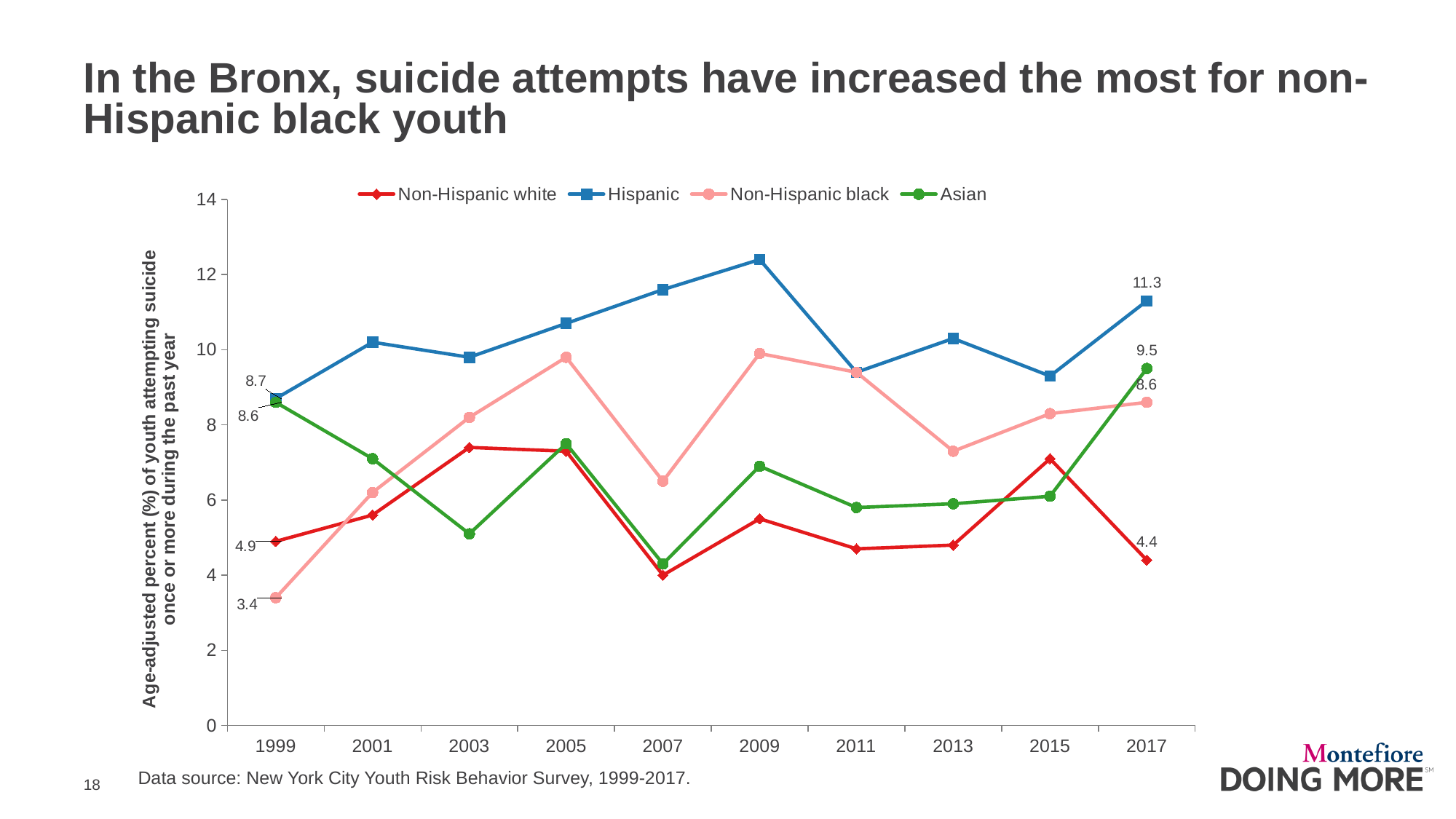
What kind of chart is shown on the slide? line chart By how much did the value for Non-Hispanic black youth change from 1999 to 2017? 5.2 Is the value for Hispanic youth in 2009 greater or less than 12? greater What is the value for Hispanic youth in 2017? 11.3 How many years are shown on the x axis? 10 What is the value for Non-Hispanic white youth in 1999? 4.9 Which group has the highest value in 2017? Hispanic What is the value for Non-Hispanic black youth in 1999? 3.4 What is the difference between the Hispanic values in 2017 and 1999? 2.6 What is the value for Asian youth in 2017? 9.5 How many series does the legend list? 4 In 2017, which is larger: the value for Hispanic youth or for Asian youth? Hispanic